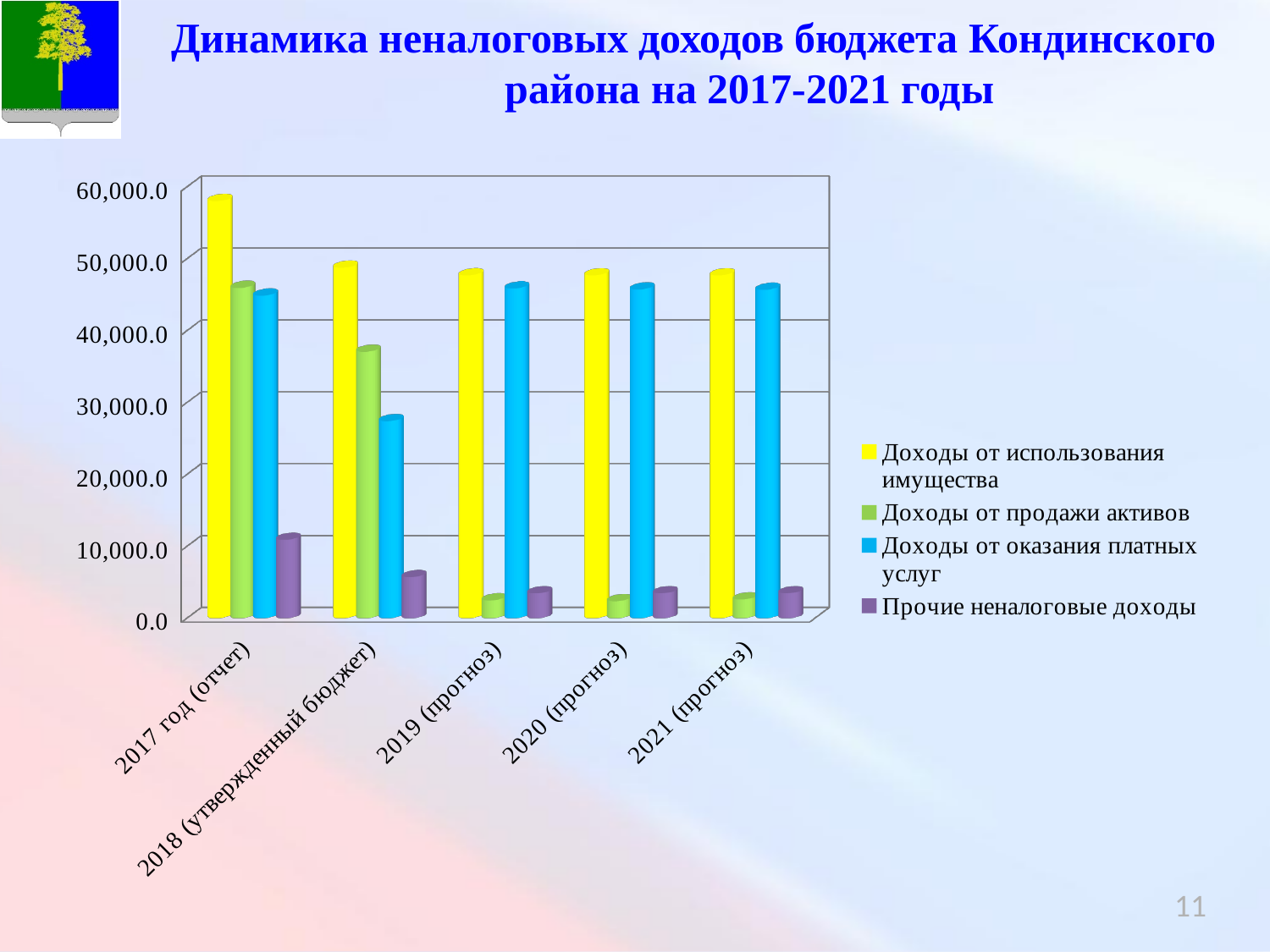
Does Доходы от продажи активов rise or fall from 2017 год (отчет) to 2019 (прогноз)? fall How many series does the legend list? 4 Which series has the highest value in 2018 (утвержденный бюджет)? Доходы от использования имущества What kind of chart is shown on the slide? bar chart How many categories are shown along the x axis? 5 Is the value for Доходы от оказания платных услуг in 2018 (утвержденный бюджет) greater or less than 30,000.0? less In which category is Доходы от использования имущества highest? 2017 год (отчет) Is the value for Доходы от использования имущества in 2017 год (отчет) greater or less than 50,000.0? greater What colour represents Прочие неналоговые доходы in the legend? purple Which is larger: Доходы от продажи активов in 2017 год (отчет) or in 2018 (утвержденный бюджет)? 2017 год (отчет) Is the value for Доходы от продажи активов in 2018 (утвержденный бюджет) greater or less than 40,000.0? less